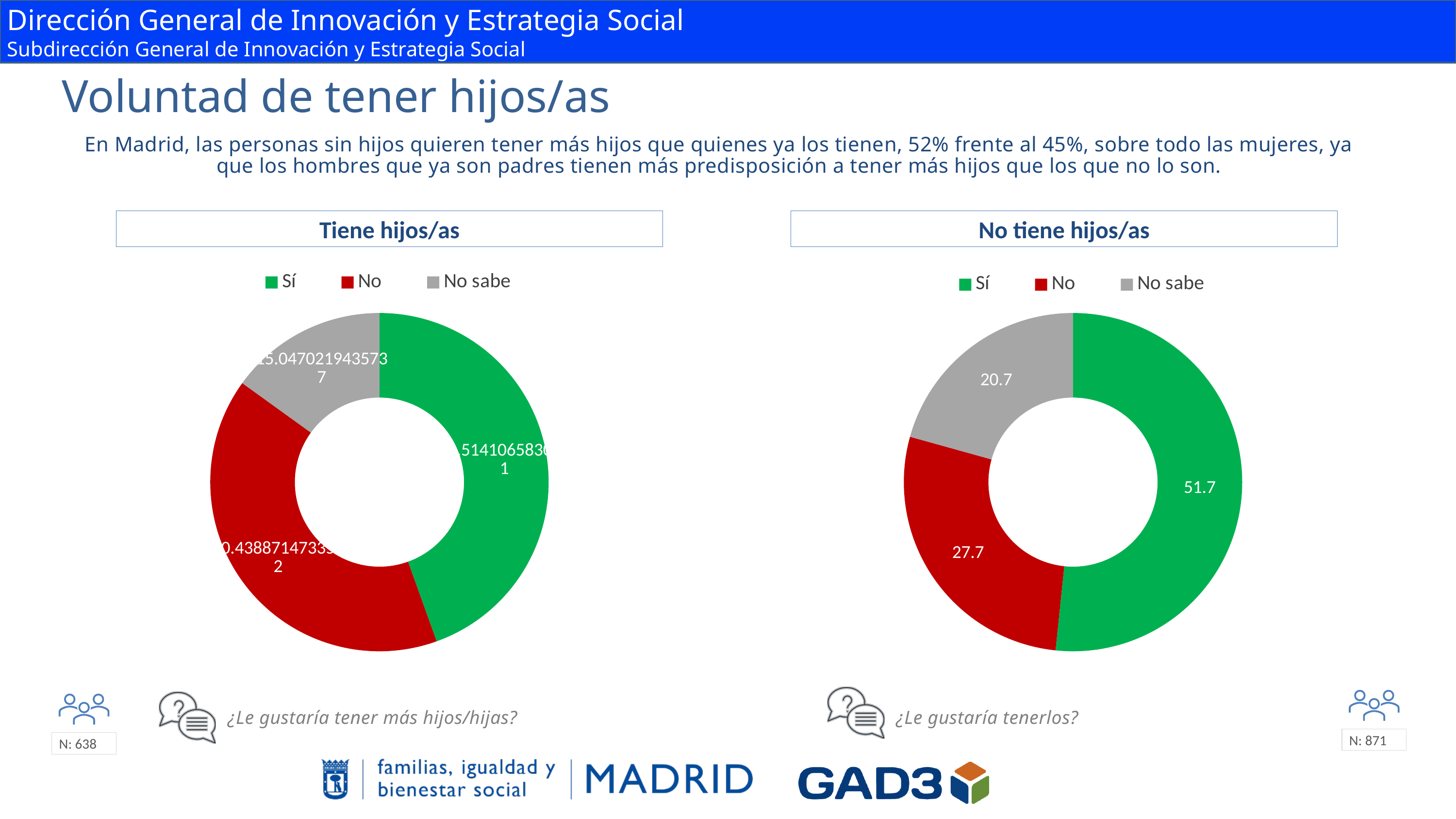
What kind of chart is the 'No tiene hijos/as' chart? Donut (pie) chart In the 'No tiene hijos/as' chart, what is the difference between the values for Sí and No? 24 In the 'No tiene hijos/as' chart, which category has the smallest share? No sabe In the 'No tiene hijos/as' chart, which is larger, No or No sabe? No In the 'Tiene hijos/as' chart, which category has the smallest share? No sabe In the 'No tiene hijos/as' chart, which category has the largest share? Sí In the 'No tiene hijos/as' chart, what is the value for No sabe? 20.7 In the 'No tiene hijos/as' chart, what is the value for Sí? 51.7 In the 'Tiene hijos/as' chart, which category has the largest share? Sí How many categories does the 'Tiene hijos/as' chart show? 3 What colour represents 'No' in the legend of the 'Tiene hijos/as' chart? Red In the 'No tiene hijos/as' chart, what is the value for No? 27.7